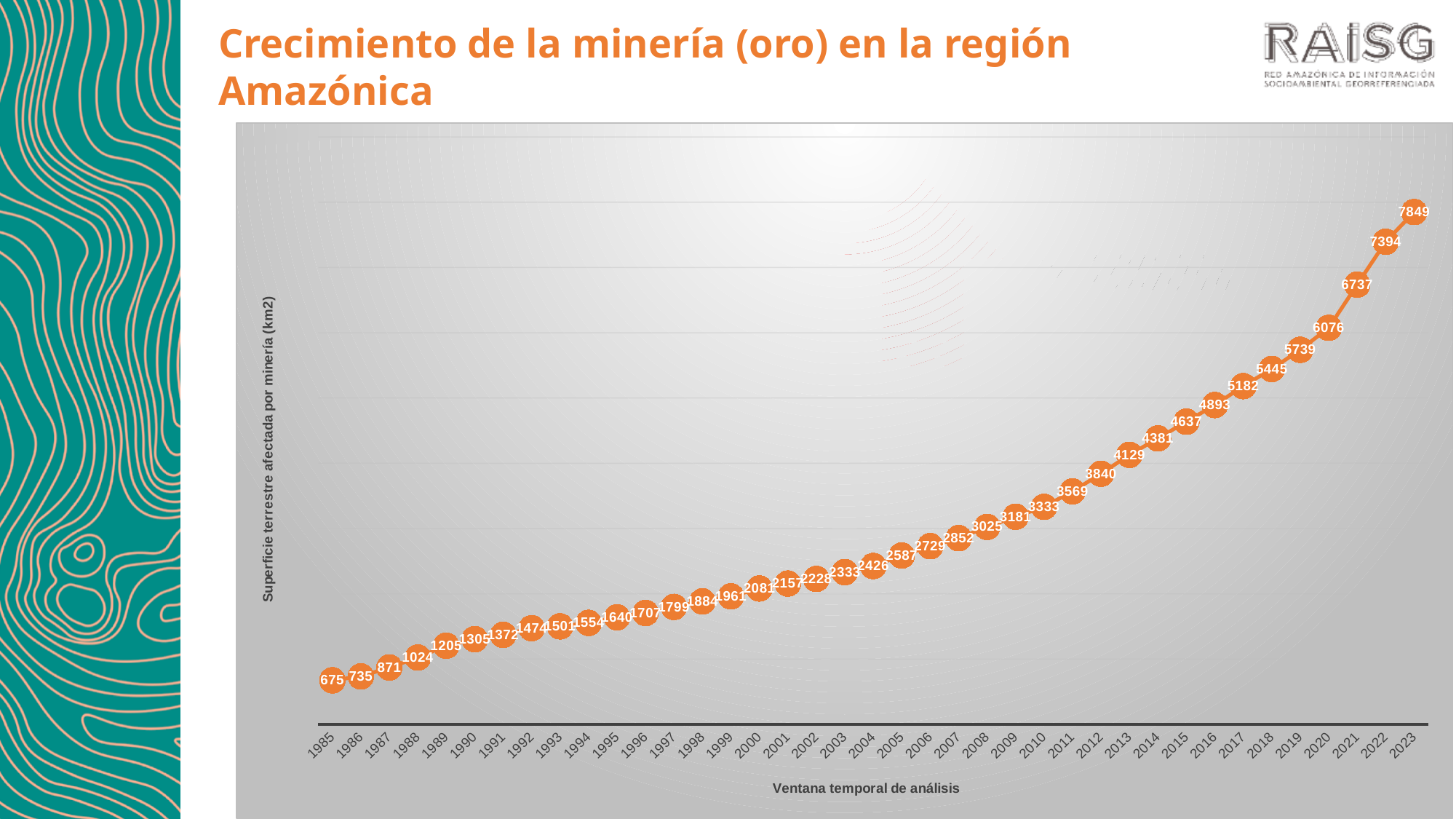
Which year has the lowest value? 1985 Do the values rise or fall from 1985 to 2023? rise How many years are plotted on the x axis? 39 What is the difference between the values for 2022 and 2021? 657 Which is larger, the value for 2015 or the value for 2005? 2015 Which year has the highest value? 2023 What is the value for 1985? 675 What is the difference between the values for 2023 and 1985? 7174 What is the value for 2010? 3333 What is the value for 2000? 2081 What kind of chart is this? line chart What is the value for 2023? 7849